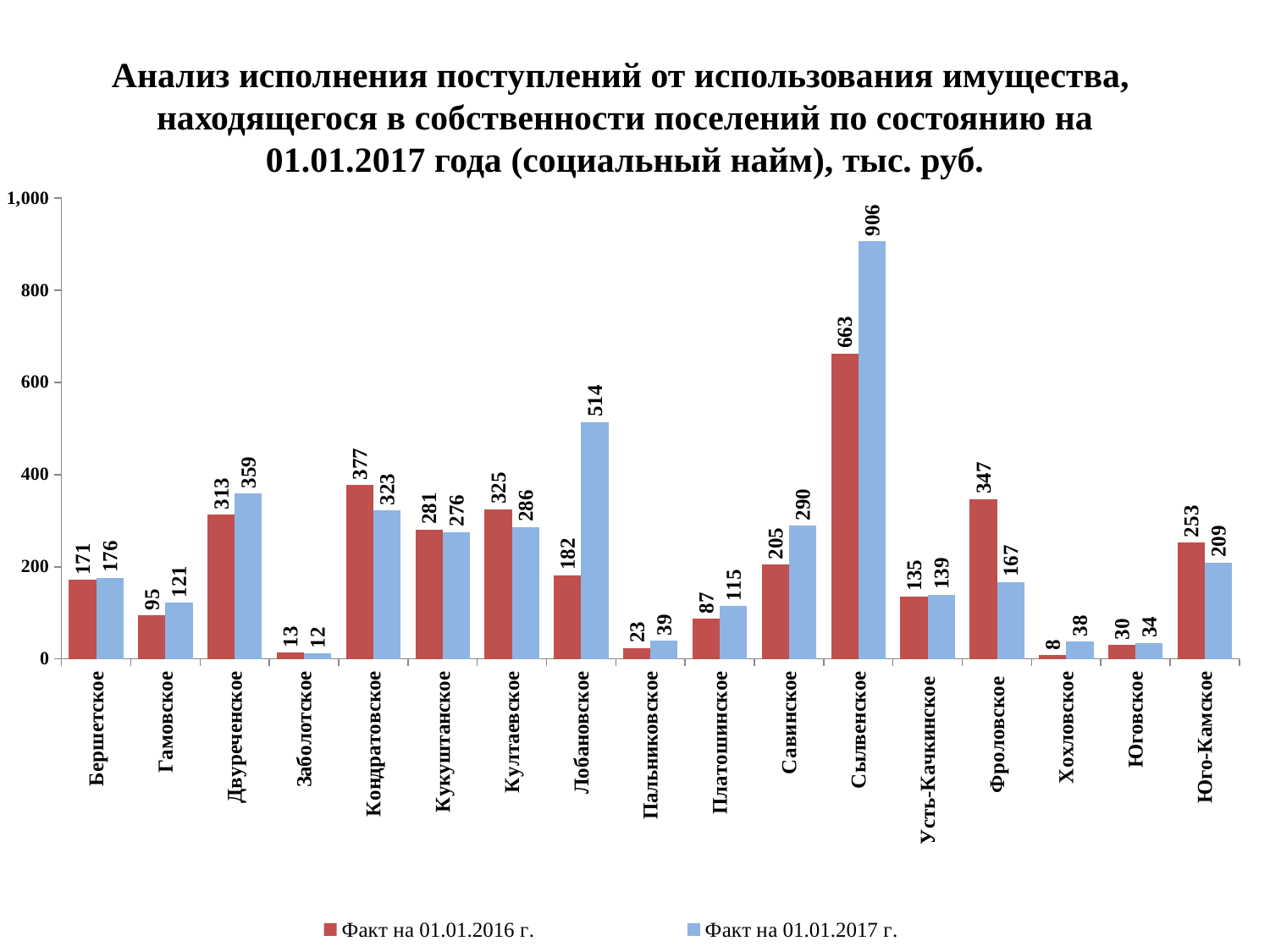
What is the value for Лобановское in the series Факт на 01.01.2017 г.? 514 What is the difference between the Факт на 01.01.2017 г. and Факт на 01.01.2016 г. values for Сылвенское? 243 Which category has the lowest value in the series Факт на 01.01.2016 г.? Хохловское How many series does the legend list? 2 What is the value for Хохловское in the series Факт на 01.01.2016 г.? 8 How many categories (settlements) are shown on the x axis? 17 For Кондратовское, which is larger: the Факт на 01.01.2016 г. value or the Факт на 01.01.2017 г. value? Факт на 01.01.2016 г. What is the value for Фроловское in the series Факт на 01.01.2016 г.? 347 What kind of chart is shown on the slide? Bar chart Is the value for Сылвенское in the series Факт на 01.01.2016 г. greater or less than 600? greater Which colour represents the series Факт на 01.01.2017 г.? Blue Which category has the highest value in the series Факт на 01.01.2017 г.? Сылвенское